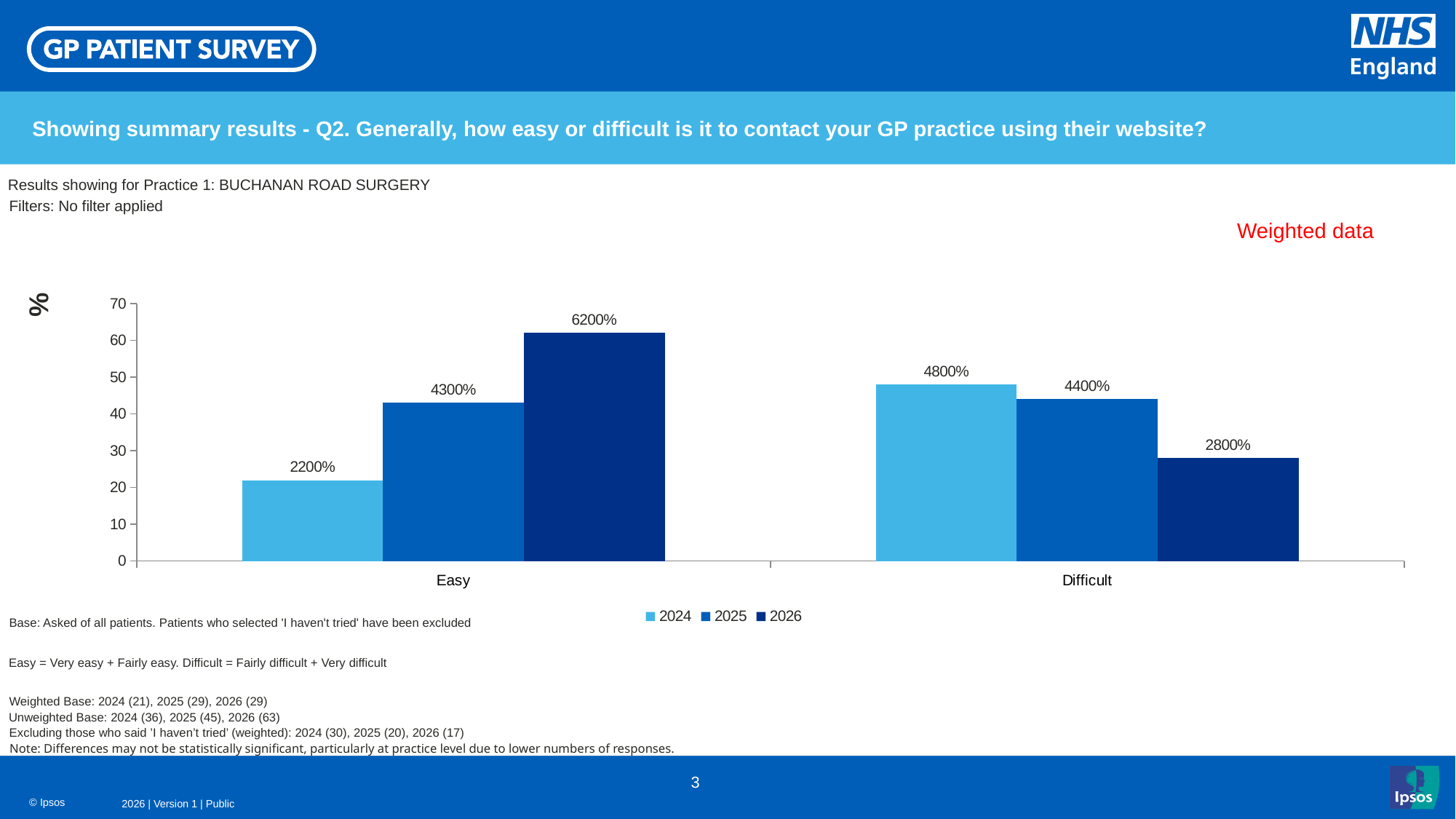
What is the data label shown for the 2025 bar in the Difficult category? 4400% What kind of chart is shown on the slide? Bar chart What is the data label shown for the 2026 bar in the Easy category? 6200% Do the bars in the Easy category rise or fall from 2024 to 2026? Rise Which is larger: the 2025 bar for Easy or the 2025 bar for Difficult? Difficult Is the 2026 bar for Difficult greater or less than 30 on the axis? less What is the data label shown for the 2024 bar in the Easy category? 2200% How many series does the legend list? 3 Which year has the lowest bar in the Difficult category? 2026 What is the data label shown for the 2024 bar in the Difficult category? 4800% How many categories are shown on the x axis? 2 Which year has the highest bar in the Easy category? 2026